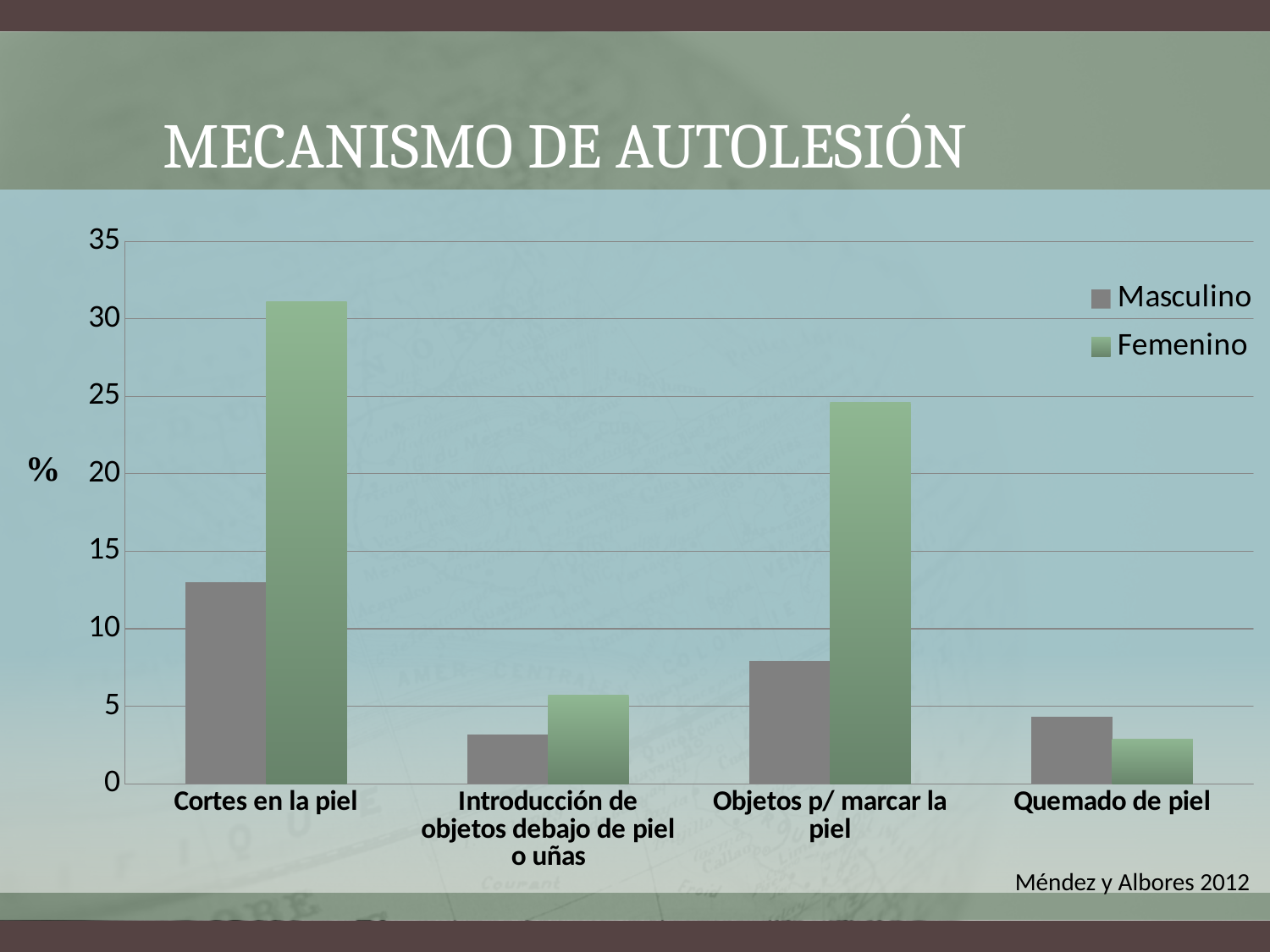
Is the Femenino value for Objetos p/ marcar la piel greater or less than 20? greater Which category has the highest Masculino value? Cortes en la piel What is the title of the chart on the slide? MECANISMO DE AUTOLESIÓN For Cortes en la piel, which series has the larger value, Masculino or Femenino? Femenino What kind of chart is shown on the slide? bar chart Which category has the highest Femenino value? Cortes en la piel Which category has the lowest Femenino value? Quemado de piel For Quemado de piel, which series has the larger value, Masculino or Femenino? Masculino Is the Femenino value for Cortes en la piel greater or less than 30? greater Is the Masculino value for Objetos p/ marcar la piel greater or less than 10? less How many series does the legend list? 2 How many categories are shown on the x axis? 4